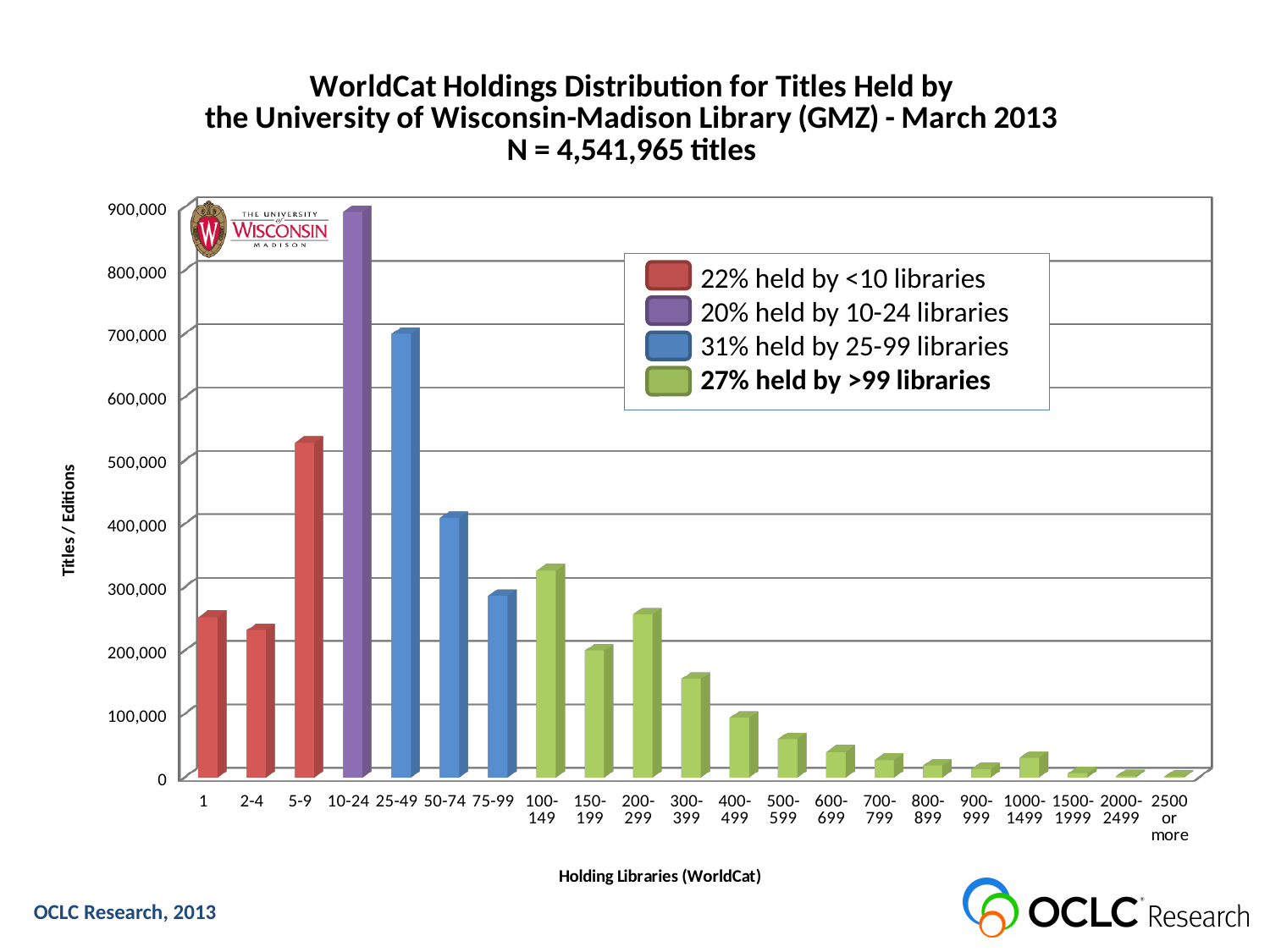
How many entries does the legend list? 4 Do the values rise or fall along the x axis from the 100-149 category to the 2500 or more category? fall Is the value for the 500-599 category greater or less than 100,000? less Which has more titles, the 100-149 category or the 200-299 category? 100-149 According to the legend, what share of titles is held by more than 99 libraries? 27% Is the value for the 75-99 category greater or less than 300,000? less What kind of chart is shown on the slide? bar chart How many holding-libraries categories are shown on the x axis? 21 Is the value for the 5-9 category greater or less than 500,000? greater Which holding-libraries category has the highest number of titles? 10-24 Which has more titles, the 5-9 category or the 25-49 category? 25-49